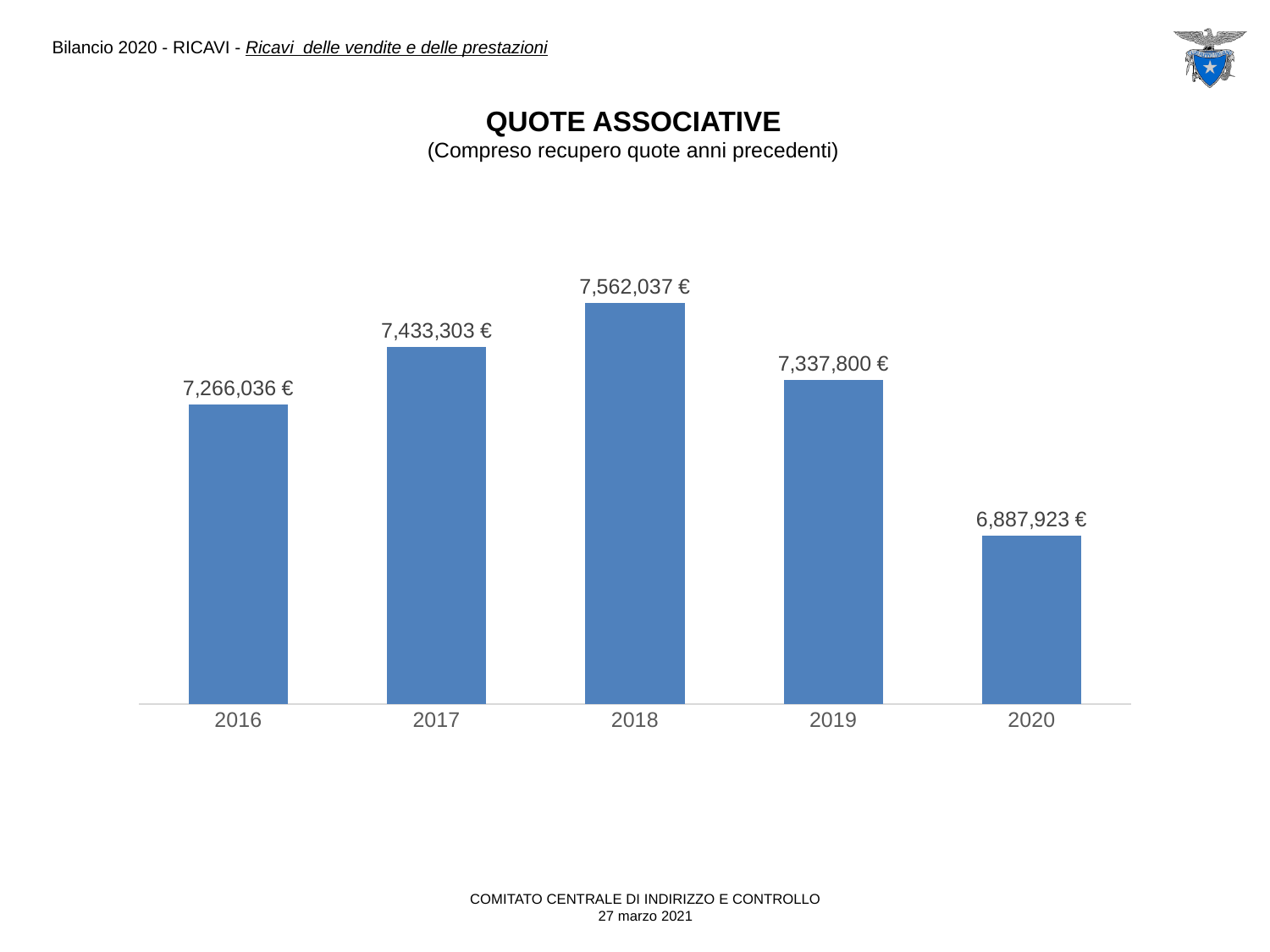
Which year has the lowest value? 2020 What is the value for 2020? 6,887,923 € What is the value for 2016? 7,266,036 € Do the values rise or fall from 2018 to 2020? fall Which is larger, the value for 2017 or the value for 2019? 2017 What is the difference between the values for 2018 and 2020? 674,114 € What kind of chart is shown? bar chart Which year has the highest value? 2018 What is the value for 2018? 7,562,037 € What is the difference between the values for 2017 and 2016? 167,267 € How many years are shown on the chart? 5 What is the title of the chart? QUOTE ASSOCIATIVE